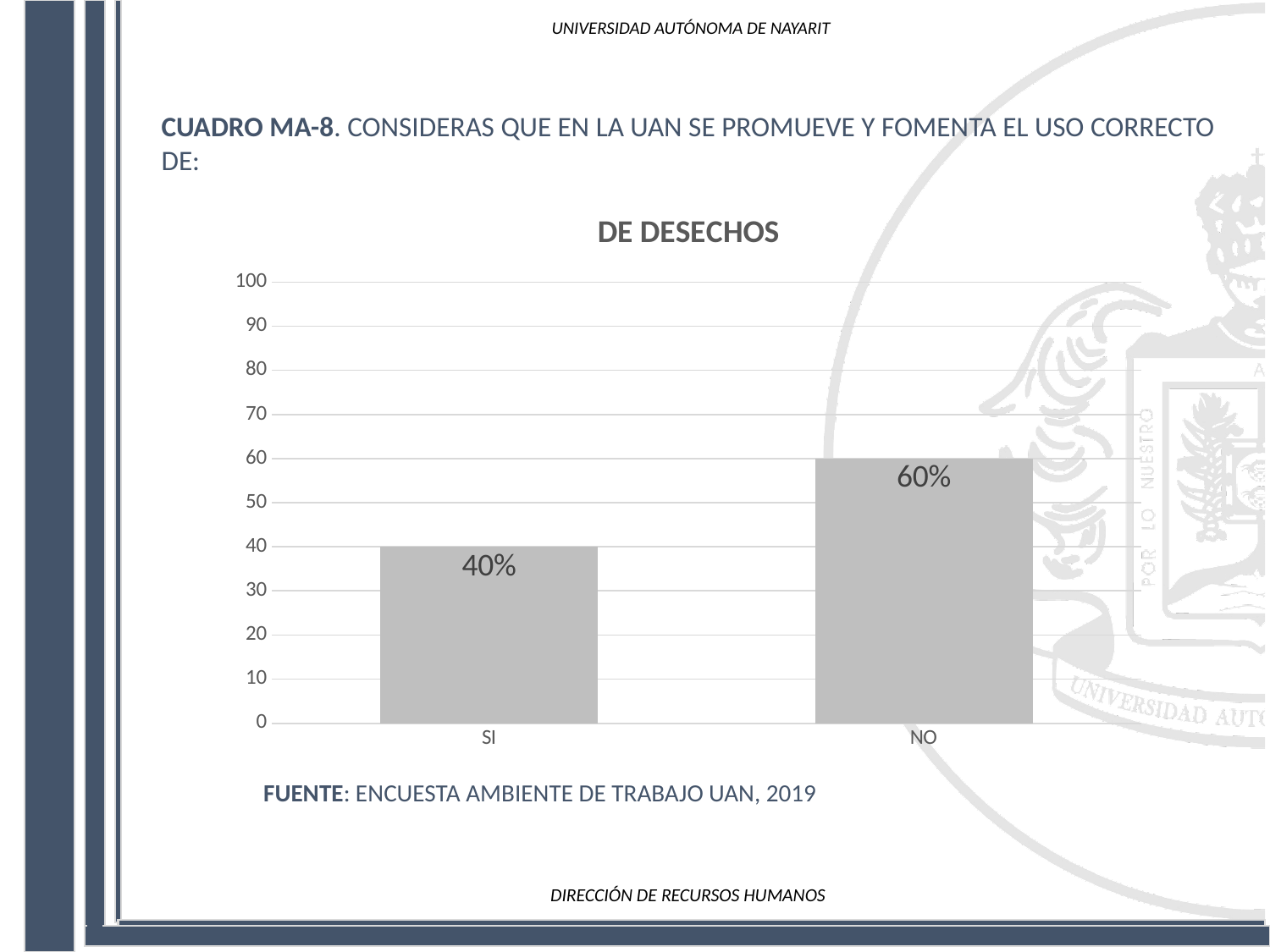
What is the title of the chart? DE DESECHOS Is the value for NO greater or less than 50? greater Which is larger, the value for SI or the value for NO? NO What is the maximum value shown on the vertical axis? 100 Which category has the highest value? NO How many categories are shown on the x axis? 2 Is the value for SI greater or less than 50? less What kind of chart is shown on the slide? bar chart Which category has the lowest value? SI What is the difference between the values for NO and SI? 20% What is the value for NO? 60% What is the value for SI? 40%